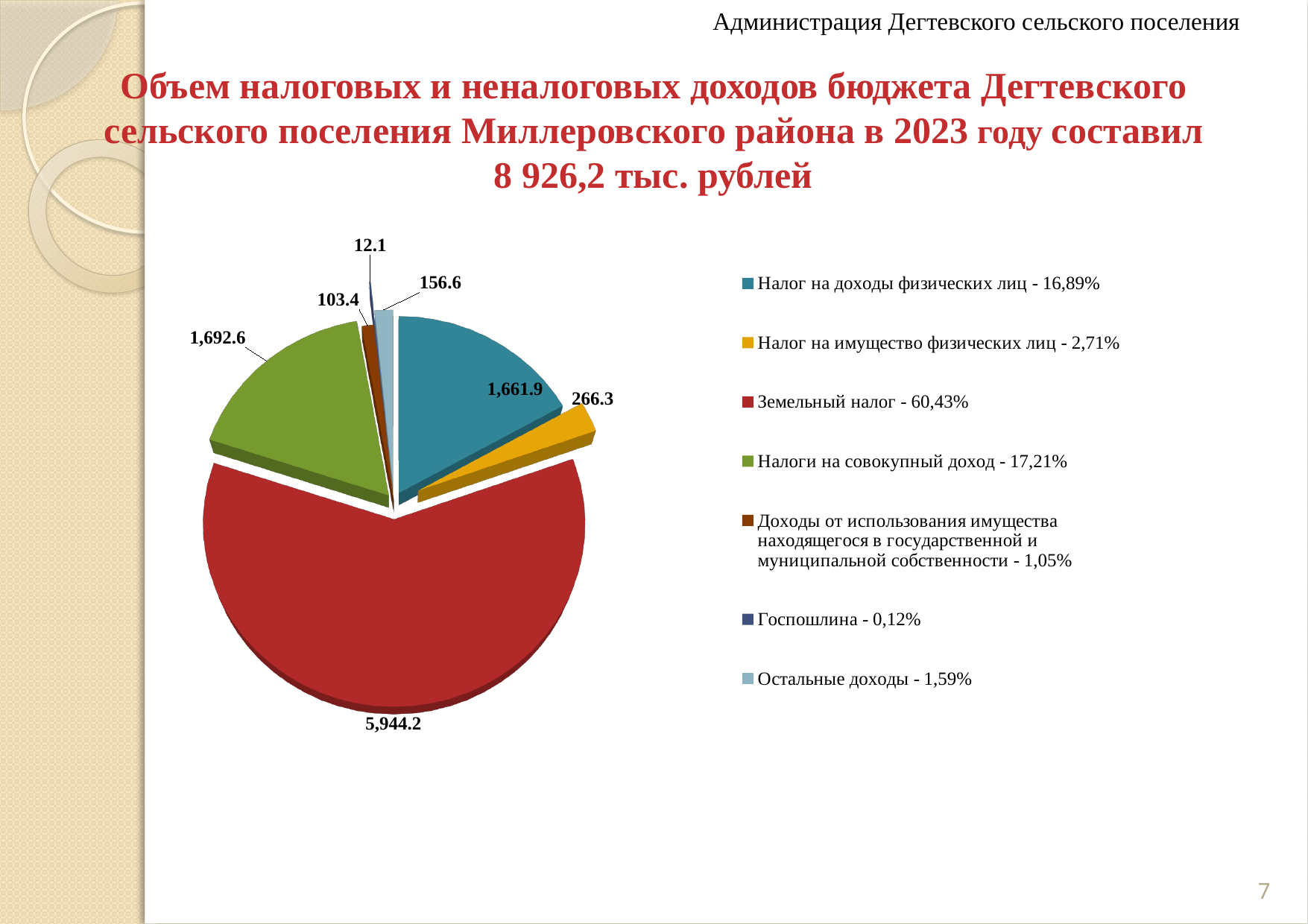
Which category has the smallest slice of the pie? Госпошлина What is the value for Госпошлина? 12.1 What is the value for Налог на доходы физических лиц? 1,661.9 What type of chart is shown on the slide? pie chart Which category has the largest slice of the pie? Земельный налог What is the value for Остальные доходы? 156.6 How many categories does the pie chart have? 7 What is the value for Земельный налог? 5,944.2 What is the value for Налоги на совокупный доход? 1,692.6 Which is larger: the value for Налог на имущество физических лиц or the value for Остальные доходы? Налог на имущество физических лиц According to the legend, what share of the pie does Земельный налог represent? 60,43% What is the difference between the values for Налоги на совокупный доход and Налог на доходы физических лиц? 30.7